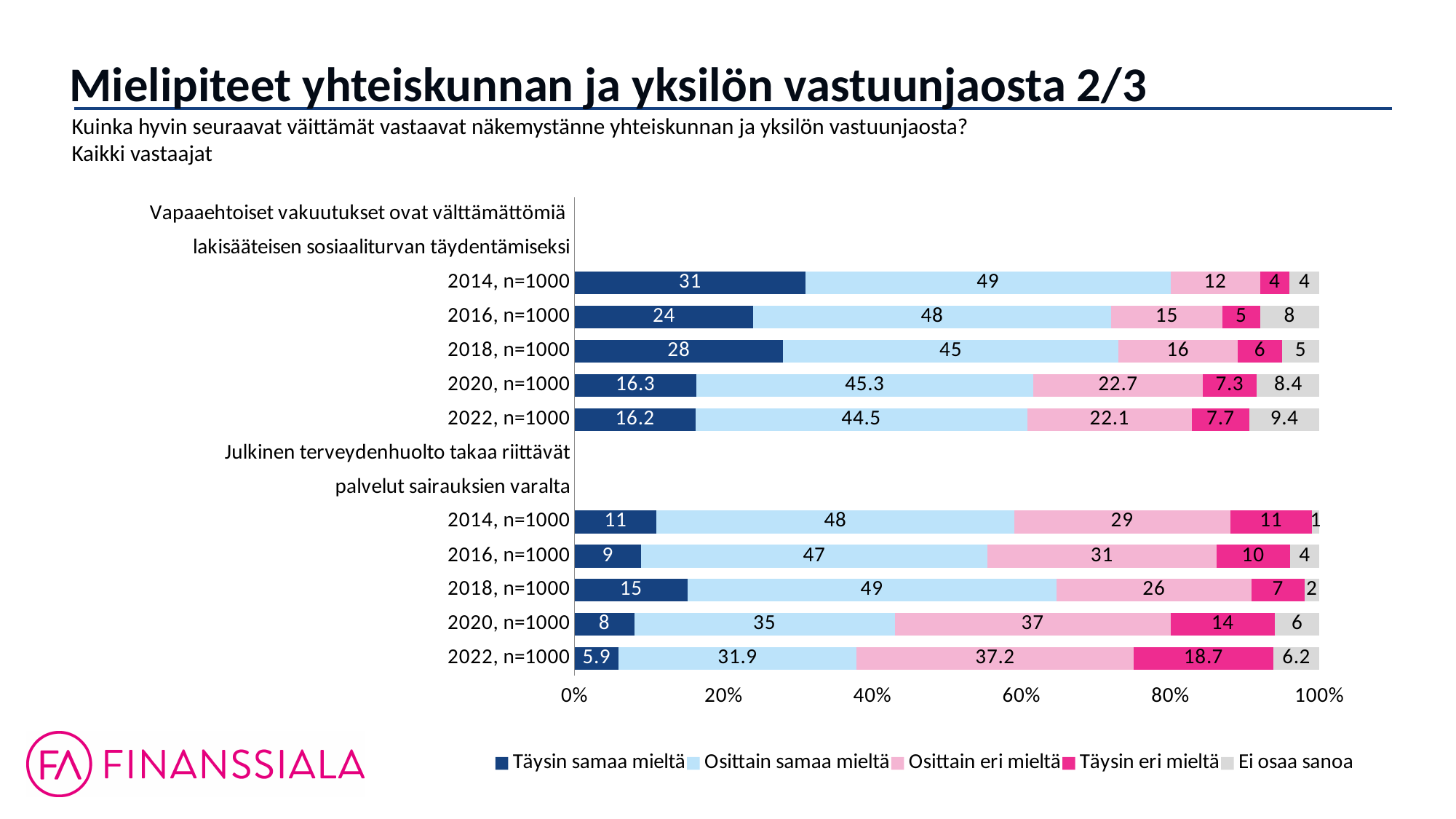
Which is larger: the "Osittain samaa mieltä" value for 2016 under "Vapaaehtoiset vakuutukset" or for 2016 under "Julkinen terveydenhuolto"? Vapaaehtoiset vakuutukset, 2016 (48) How many bars are plotted in the chart? 10 What is the total of the 2014, n=1000 stacked bar under "Vapaaehtoiset vakuutukset"? 100 How many series does the legend list? 5 Among the "Vapaaehtoiset vakuutukset" bars, which year has the highest "Täysin samaa mieltä" value? 2014, n=1000 Under "Julkinen terveydenhuolto takaa riittävät palvelut sairauksien varalta", how much larger is the "Osittain eri mieltä" value in 2022 than in 2014? 8.2 What is the value for "Ei osaa sanoa" in the 2020, n=1000 bar under "Vapaaehtoiset vakuutukset ovat välttämättömiä lakisääteisen sosiaaliturvan täydentämiseksi"? 8.4 What kind of chart is shown on the slide? Stacked horizontal bar chart What is the value for "Täysin eri mieltä" in the 2022, n=1000 bar under "Julkinen terveydenhuolto takaa riittävät palvelut sairauksien varalta"? 18.7 What is the value for "Täysin samaa mieltä" in the 2014, n=1000 bar under "Vapaaehtoiset vakuutukset ovat välttämättömiä lakisääteisen sosiaaliturvan täydentämiseksi"? 31 Among the "Julkinen terveydenhuolto" bars, which year has the lowest "Täysin samaa mieltä" value? 2022, n=1000 Under "Vapaaehtoiset vakuutukset", does the "Täysin eri mieltä" value rise or fall from 2014 to 2022? Rises